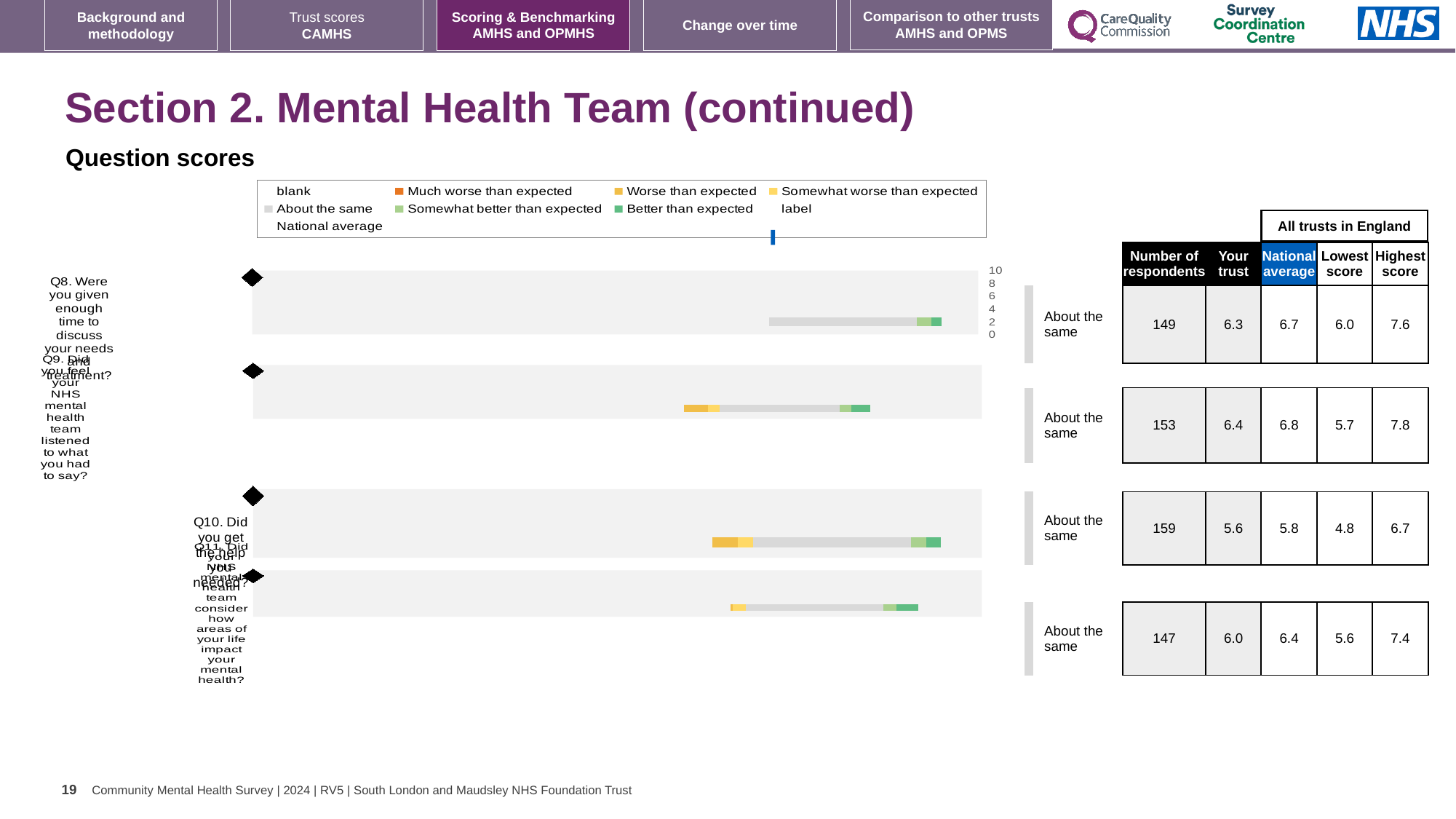
In the table beside the charts, for Q9, which is larger: the 'Your trust' score or the national average? National average In the table beside the charts, what is the highest score for Q9? 7.8 In the table beside the charts, which question has the largest number of respondents? Q10 What kind of chart is used to show the question scores for Q8 to Q11? bar chart In the table beside the charts, what is the difference between the highest score and the lowest score for Q8? 1.6 In the chart legend, what colour represents 'Much worse than expected'? orange In the table beside the charts, what is the national average for Q11? 6.4 In the table beside the charts, which question has the lowest 'Your trust' score? Q10 In the chart legend, what colour represents 'Better than expected'? green How many questions (Q8 to Q11) have a bar chart on this slide? 4 In the table beside the charts, what is the number of respondents for Q8? 149 In the table beside the charts, what is the 'Your trust' score for Q10? 5.6